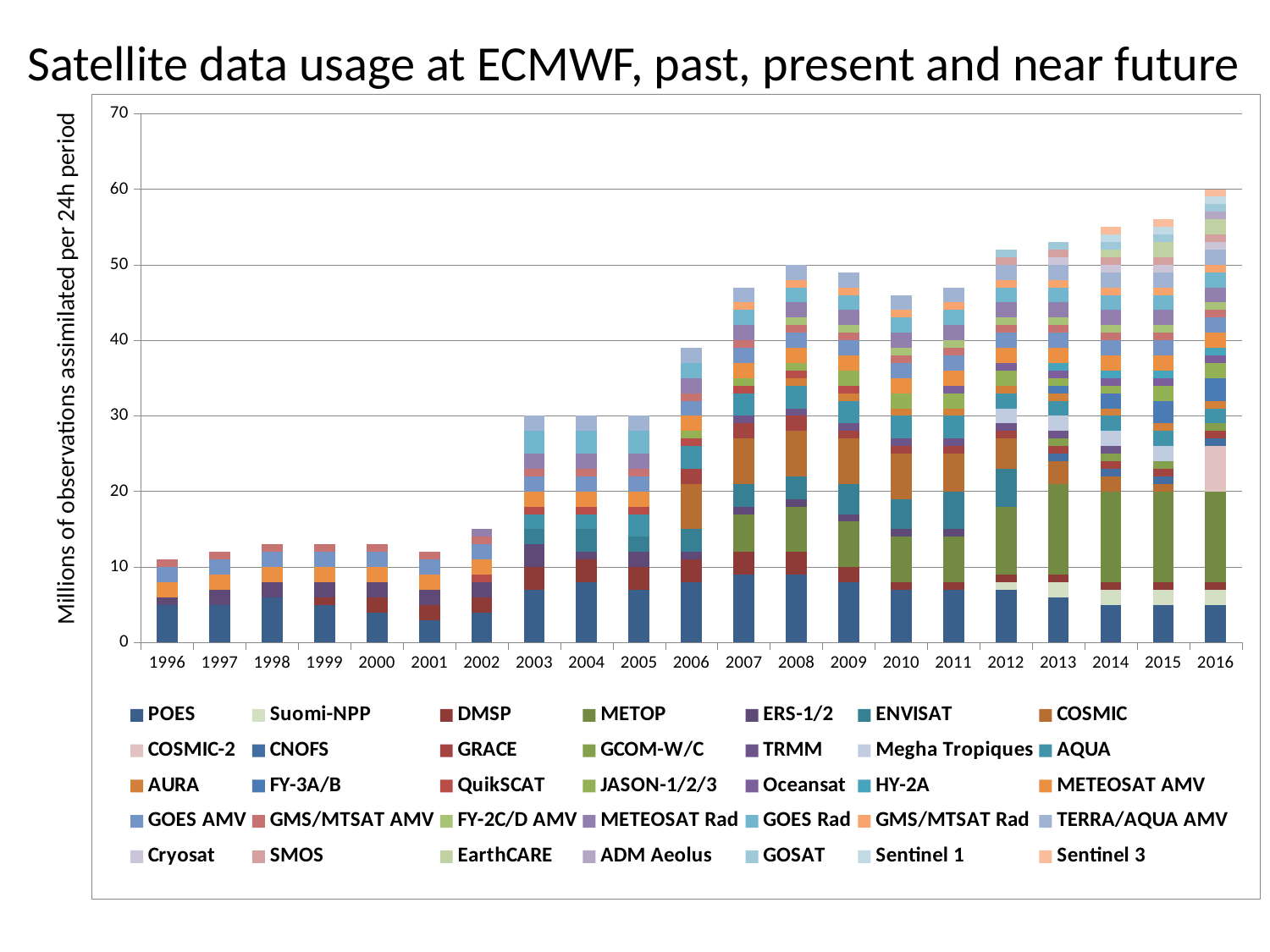
What is the total height of the bar for 2008, in millions of observations per 24h period? 50 Do the total observations generally rise or fall from 1996 to 2016? Rise What is the total height of the bar for 2003, in millions of observations per 24h period? 30 Is the total value for 2007 greater or less than 50? less How many series does the chart's legend list? 35 What is the label on the vertical axis of the chart? Millions of observations assimilated per 24h period Is the total value for 2016 greater or less than 50? greater Which year has the larger total bar, 2003 or 2002? 2003 How many years are shown along the x axis of the chart? 21 What kind of chart is shown on the slide? Stacked bar chart Is the total value for 2002 greater or less than 10? greater Which year has the highest total of observations assimilated? 2016